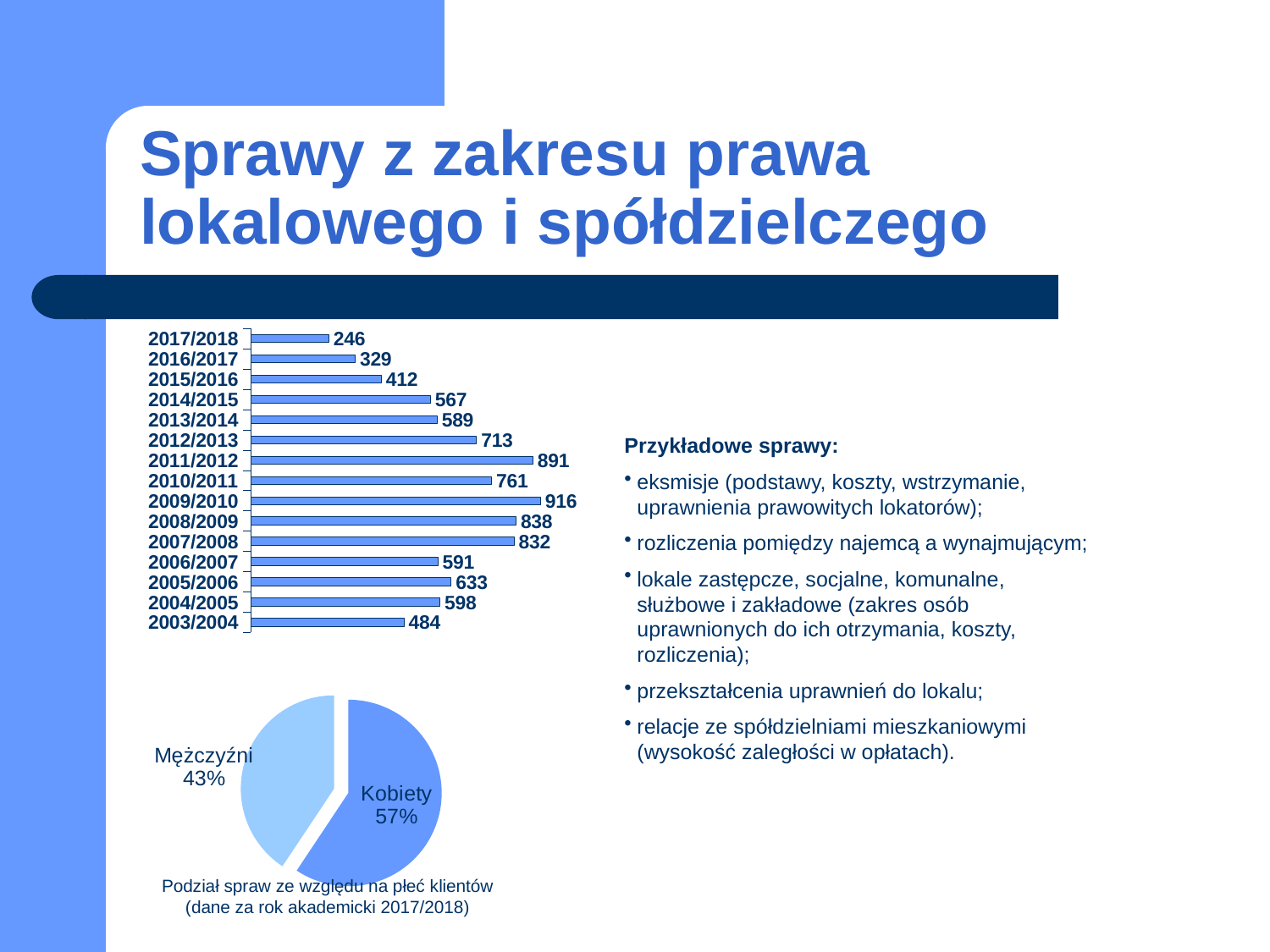
How many academic years are shown in the bar chart at the top left? 15 In the bar chart at the top left, what is the value for 2009/2010? 916 What kind of chart is the chart at the top left of the slide? bar chart In the bar chart at the top left, which is larger, the value for 2012/2013 or the value for 2013/2014? 2012/2013 In the bar chart at the top left, what is the value for 2003/2004? 484 In the bar chart at the top left, what is the value for 2017/2018? 246 In the pie chart at the bottom left, what share is labelled Kobiety? 57% In the bar chart at the top left, which academic year has the lowest value? 2017/2018 What kind of chart is the chart at the bottom left of the slide? pie chart In the bar chart at the top left, which academic year has the highest value? 2009/2010 In the bar chart at the top left, what is the difference between the values for 2011/2012 and 2010/2011? 130 In the pie chart at the bottom left, what share is labelled Mężczyźni? 43%